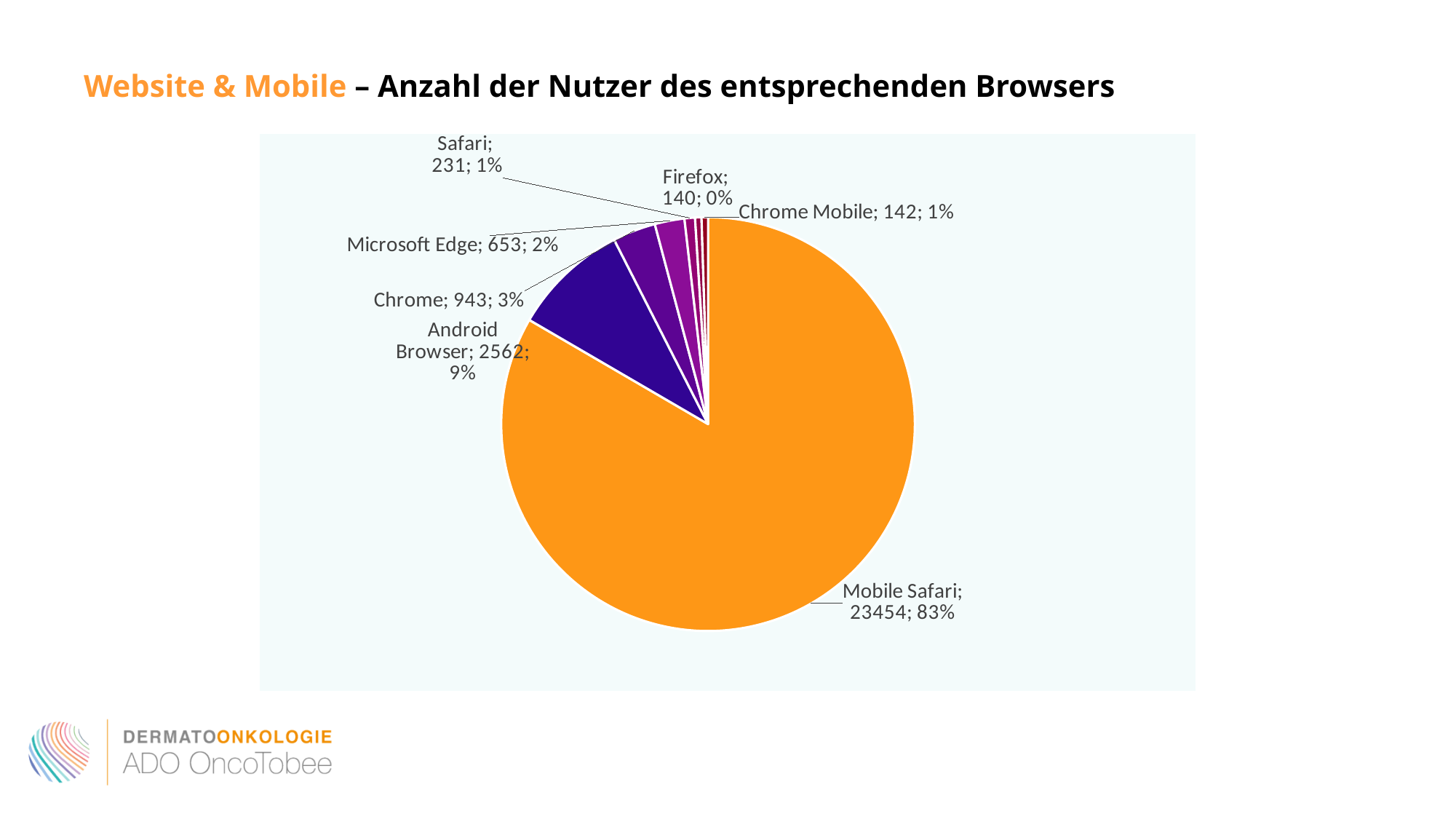
How many users does the Android Browser have? 2562 Which has more users, Safari or Chrome Mobile? Safari How many browser categories are shown in the pie chart? 7 Which browser has the fewest users? Firefox What share of the pie does Chrome represent? 3% Which browser has the most users? Mobile Safari How many users does Mobile Safari have? 23454 What is the difference in users between Chrome and Microsoft Edge? 290 How many users does Microsoft Edge have? 653 What is the title of the slide? Website & Mobile – Anzahl der Nutzer des entsprechenden Browsers What share of the pie does Mobile Safari represent? 83% What type of chart is shown on the slide? pie chart